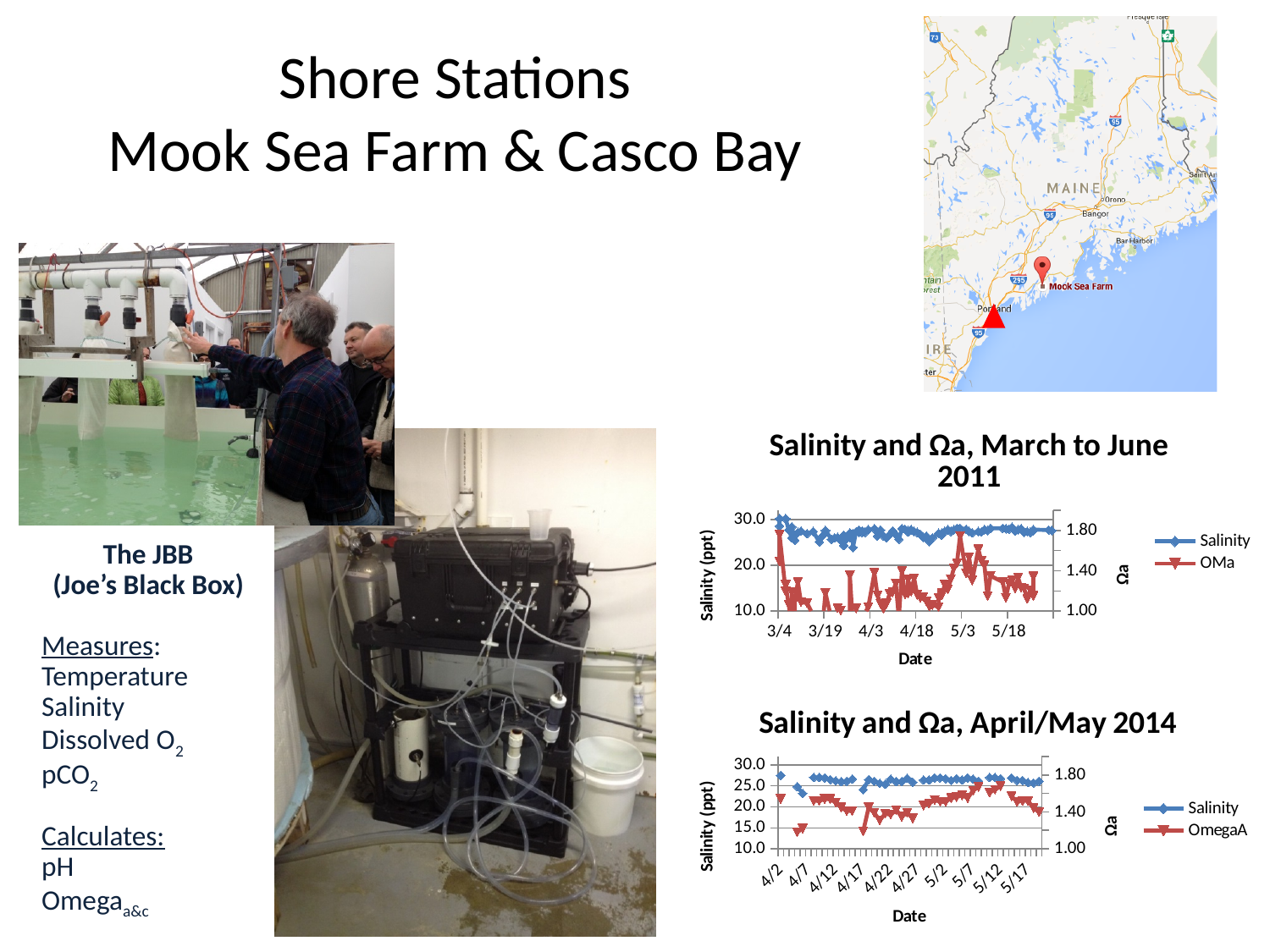
How many series does the legend of "Salinity and Ωa, March to June 2011" list? 2 In "Salinity and Ωa, April/May 2014", what is the label of the left vertical axis? Salinity (ppt) In "Salinity and Ωa, March to June 2011", which series is plotted higher on the chart for most of the period, Salinity or OMa? Salinity In "Salinity and Ωa, April/May 2014", is the Salinity value on 5/2 greater or less than 20.0? greater In "Salinity and Ωa, March to June 2011", is the Salinity value on 4/18 greater or less than 20.0? greater What kind of chart is "Salinity and Ωa, March to June 2011"? line chart What kind of chart is "Salinity and Ωa, April/May 2014"? line chart In "Salinity and Ωa, March to June 2011", what are the two series named in the legend? Salinity and OMa How many series does the legend of "Salinity and Ωa, April/May 2014" list? 2 In "Salinity and Ωa, April/May 2014", is the OmegaA value on 4/22 greater or less than 1.80? less In "Salinity and Ωa, April/May 2014", which series is plotted higher on the chart for most of the period, Salinity or OmegaA? Salinity